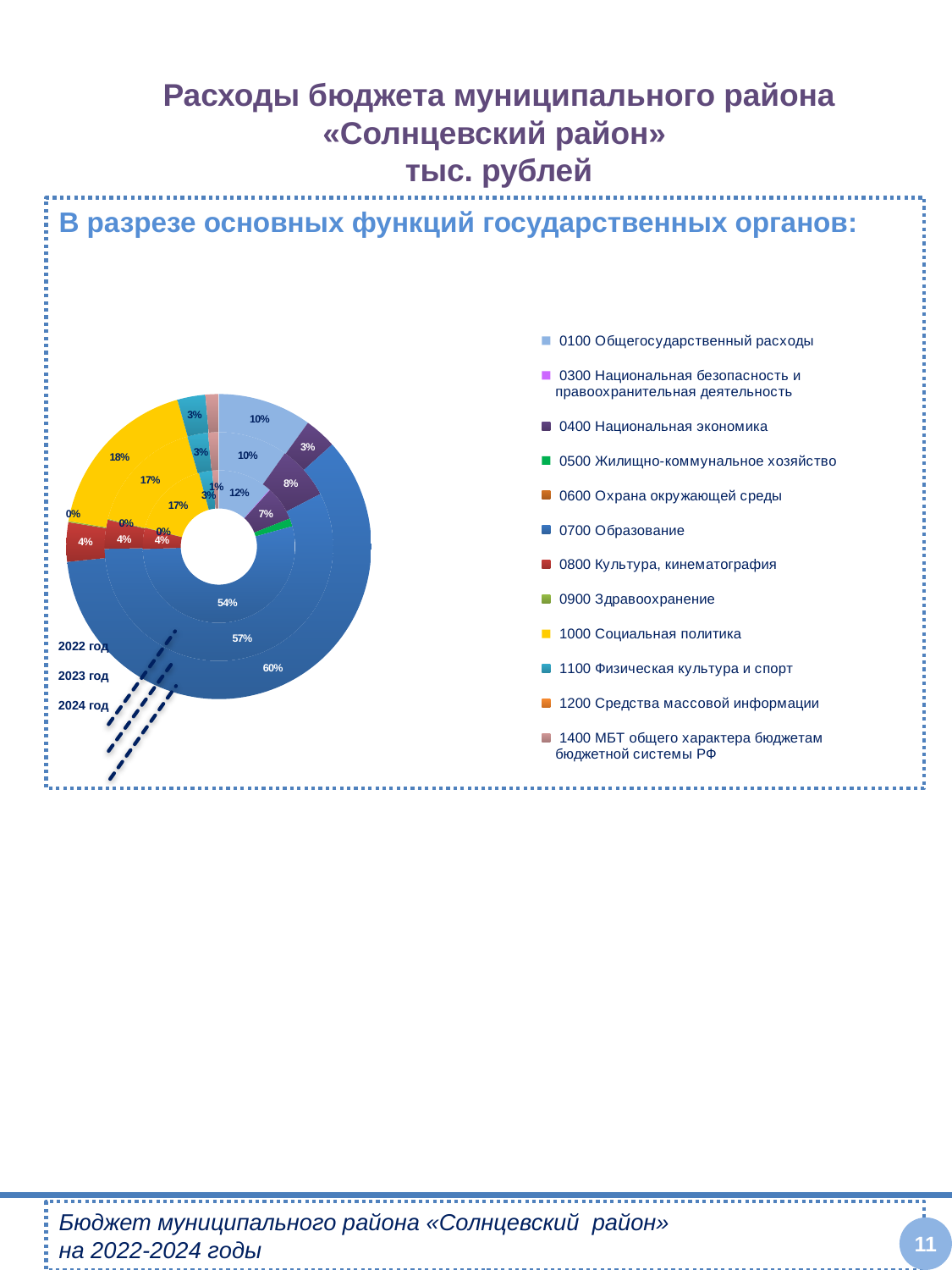
How many categories does the legend of the chart list? 12 By how many percentage points does the share of 0700 Образование in 2024 год exceed its share in 2022 год? 6 percentage points What share does 0700 Образование have in the inner ring (2022 год)? 54% How many years (rings) does the doughnut chart show? 3 What kind of chart is shown on the slide? Pie (doughnut) chart What share does 0700 Образование have in the outer ring (2024 год)? 60% Does the share of 0700 Образование rise or fall from 2022 год to 2024 год? Rises What share does 1000 Социальная политика have in the outer ring (2024 год)? 18% What share does 0700 Образование have in the middle ring (2023 год)? 57% What share does 0400 Национальная экономика have in the middle ring (2023 год)? 8% Which category has the largest share in every ring of the chart? 0700 Образование In the outer ring (2024 год), which is larger: the share of 1000 Социальная политика or 0100 Общегосударственный расходы? 1000 Социальная политика